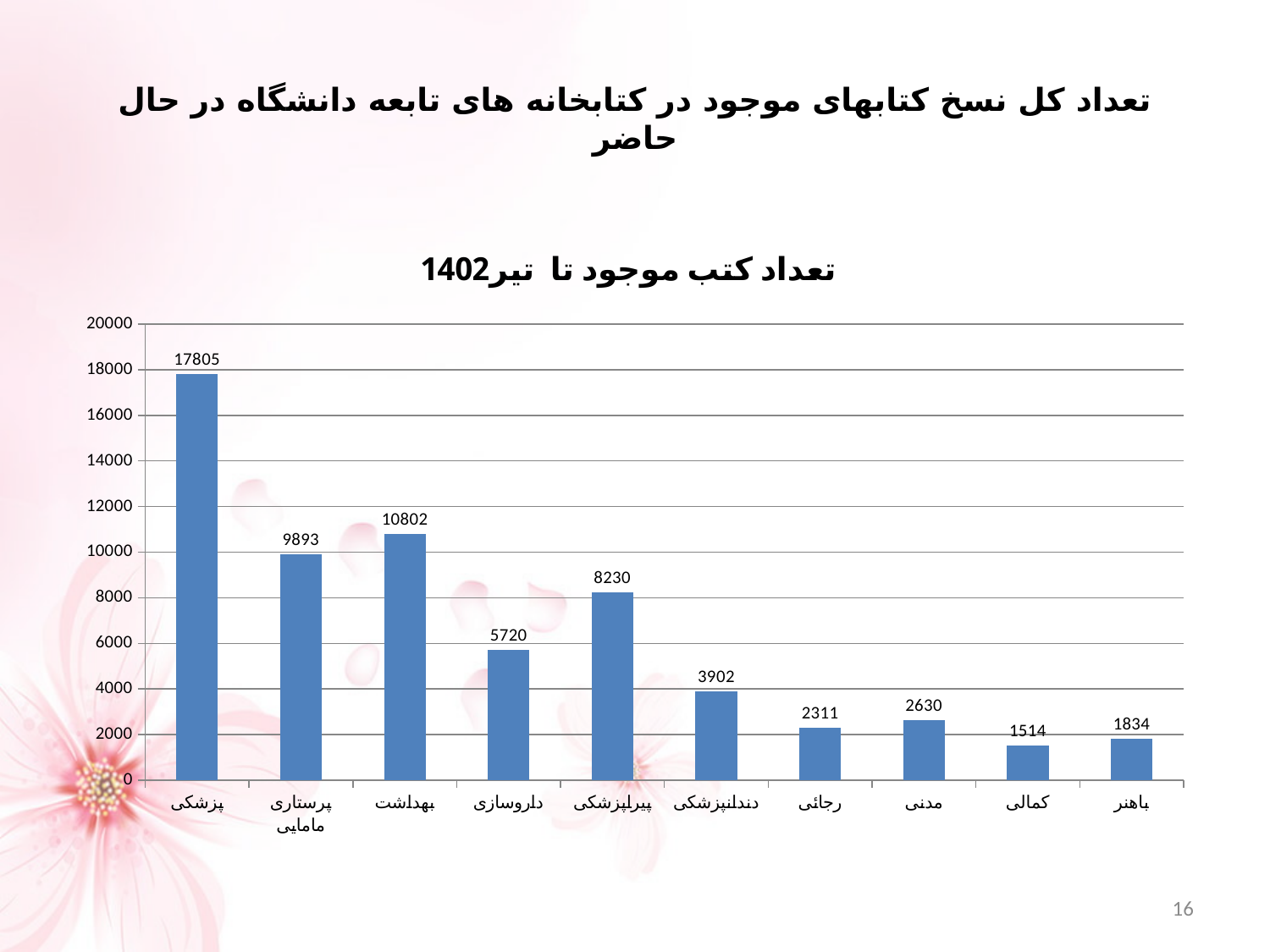
Which is larger, the value for مدنی or the value for رجائی? مدنی What is the title of the chart? تعداد کتب موجود تا تیر1402 What is the difference between the values for باهنر and کمالی? 320 What is the value for کمالی in the chart? 1514 How many categories are shown on the x axis of the chart? 10 What is the value for پزشکی in the chart? 17805 Which category has the highest value in the chart? پزشکی Is the value for پیراپزشکی greater or less than 8000? greater Which category has the lowest value in the chart? کمالی What is the difference between the values for بهداشت and پرستاری مامایی? 909 What kind of chart is shown on the slide? bar chart What is the value for داروسازی in the chart? 5720